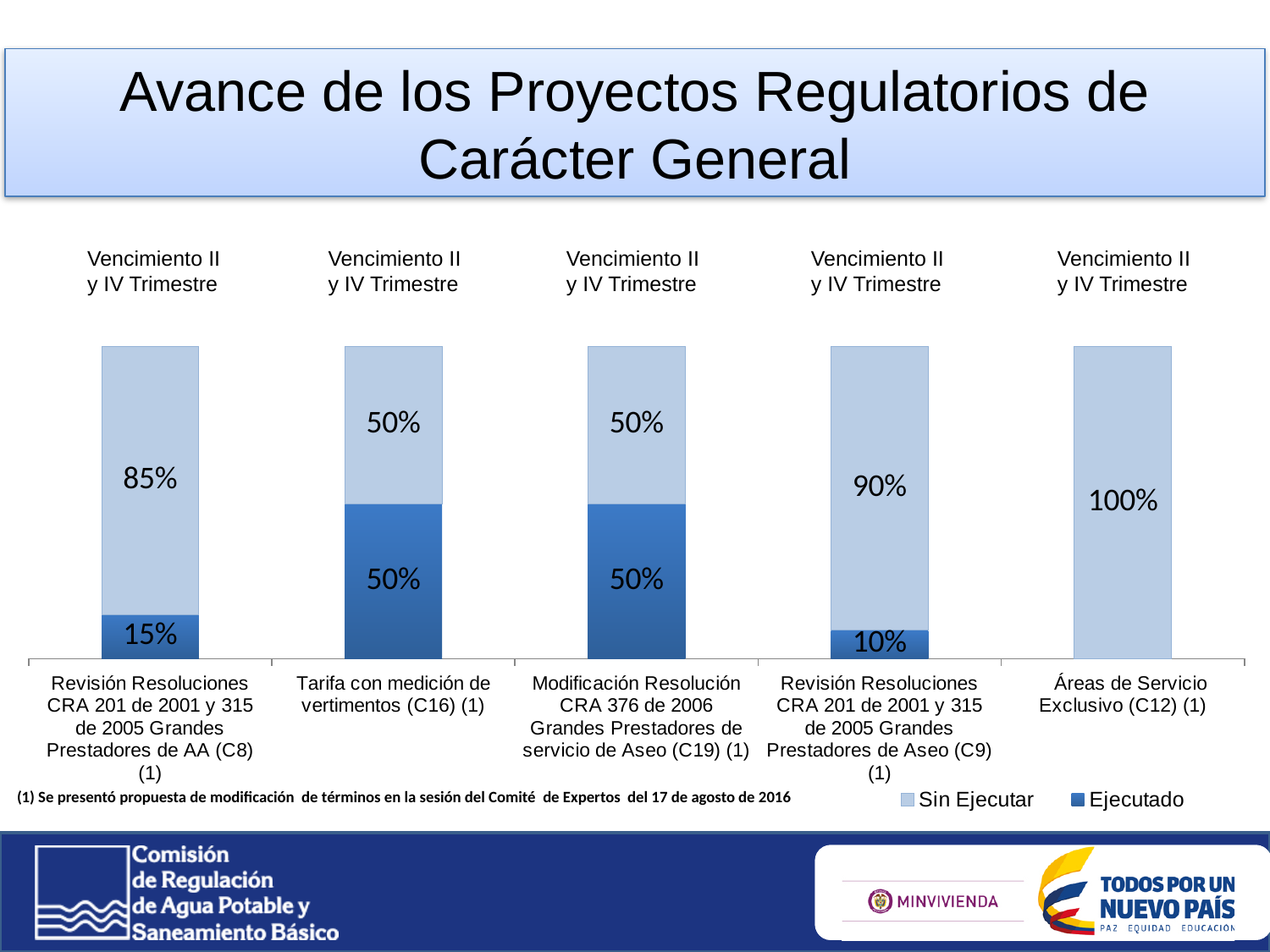
Which category has the lowest Ejecutado value among those with an Ejecutado label? Revisión Resoluciones CRA 201 de 2001 y 315 de 2005 Grandes Prestadores de Aseo (C9) Which legend entry is shown in the darker blue colour? Ejecutado What is the Sin Ejecutar value for Áreas de Servicio Exclusivo (C12)? 100% How many series does the legend list? 2 What type of chart is shown on the slide? Stacked bar chart What is the Ejecutado value for Revisión Resoluciones CRA 201 de 2001 y 315 de 2005 Grandes Prestadores de AA (C8)? 15% How many project categories are plotted in the chart? 5 Which category has the highest Sin Ejecutar value? Áreas de Servicio Exclusivo (C12) What is the difference between the Sin Ejecutar and Ejecutado values for Revisión Resoluciones CRA 201 de 2001 y 315 de 2005 Grandes Prestadores de AA (C8)? 70% What is the Sin Ejecutar value for Revisión Resoluciones CRA 201 de 2001 y 315 de 2005 Grandes Prestadores de Aseo (C9)? 90% What is the Ejecutado value for Tarifa con medición de vertimentos (C16)? 50% Which category has the highest Ejecutado value, Revisión Resoluciones CRA 201 de 2001 y 315 de 2005 Grandes Prestadores de AA (C8) or Modificación Resolución CRA 376 de 2006 Grandes Prestadores de servicio de Aseo (C19)? Modificación Resolución CRA 376 de 2006 Grandes Prestadores de servicio de Aseo (C19)